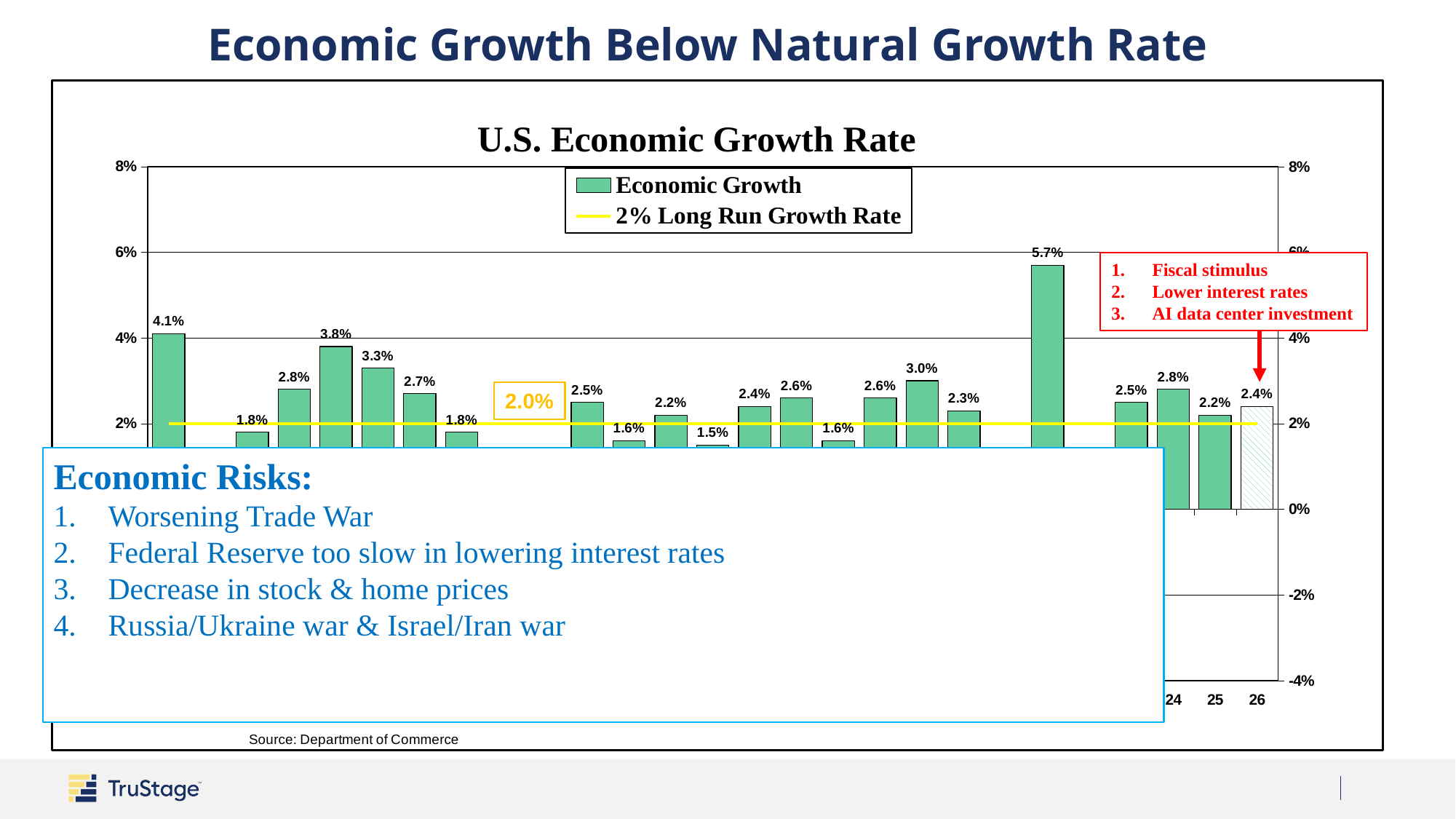
How many series does the legend list? 2 What is the title of the chart? U.S. Economic Growth Rate What kind of chart is used to show economic growth? Bar chart What is the difference between the growth rates for 24 and 25? 0.6% Is the growth rate for 25 greater or less than 2%? greater What value does the long run growth rate line represent? 2.0% Which has the higher growth rate, 24 or 26? 24 What is the lowest economic growth rate labeled on the chart? 1.5% What is the economic growth rate shown for 25? 2.2% What is the economic growth rate shown for 26? 2.4% What is the highest economic growth rate labeled on the chart? 5.7% What is the economic growth rate shown for 24? 2.8%